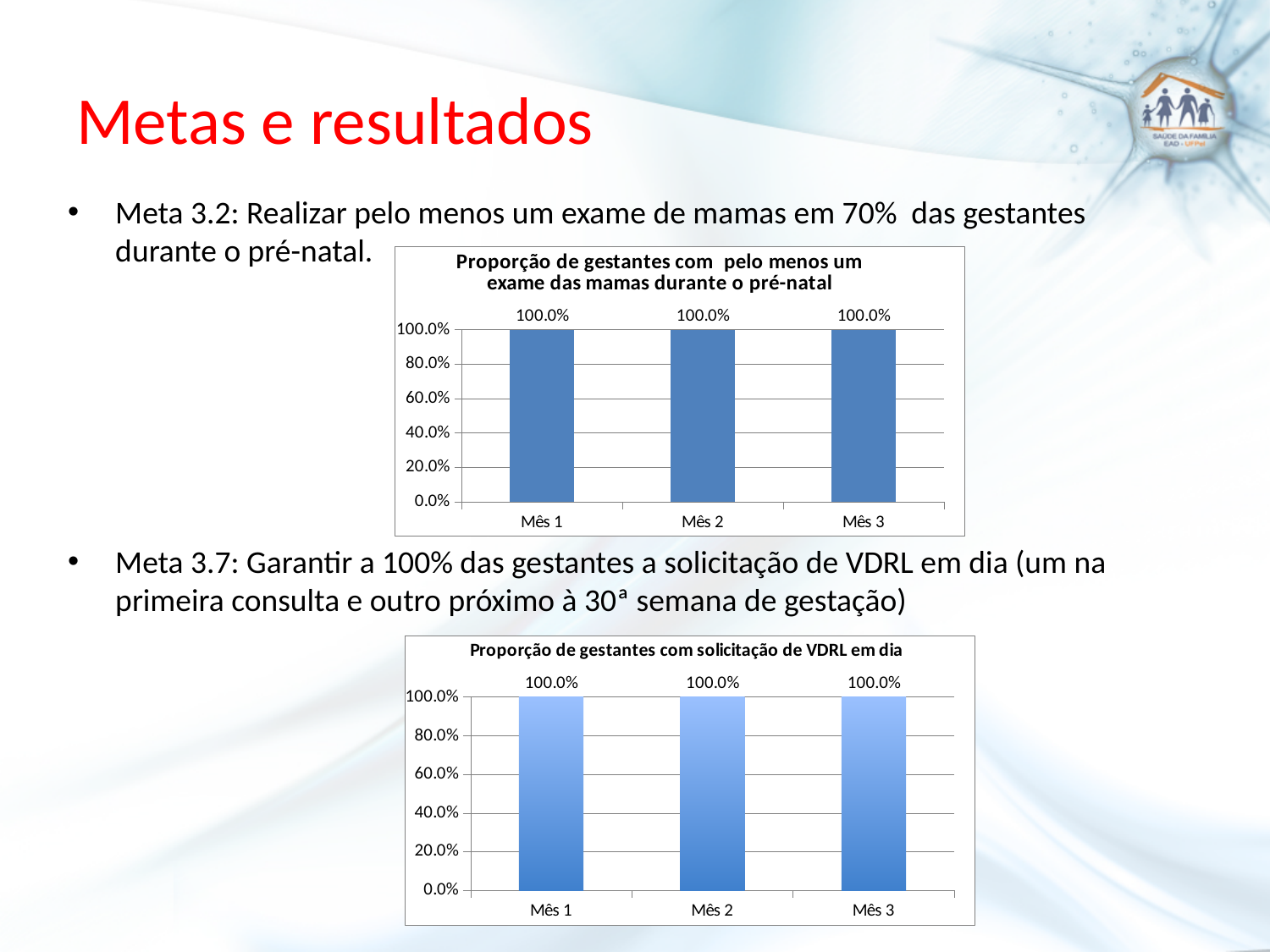
In the bottom chart (Proporção de gestantes com solicitação de VDRL em dia), what is the difference between the values for Mês 3 and Mês 1? 0.0% In the top chart (Proporção de gestantes com pelo menos um exame das mamas durante o pré-natal), what is the value for Mês 1? 100.0% In the top chart (Proporção de gestantes com pelo menos um exame das mamas durante o pré-natal), is the value for Mês 2 greater or less than 80.0%? greater In the top chart (Proporção de gestantes com pelo menos um exame das mamas durante o pré-natal), what is the difference between the values for Mês 1 and Mês 2? 0.0% In the bottom chart (Proporção de gestantes com solicitação de VDRL em dia), do the values rise, fall or stay the same from Mês 1 to Mês 3? Stay the same In the top chart (Proporção de gestantes com pelo menos um exame das mamas durante o pré-natal), what is the value for Mês 3? 100.0% What is the title of the bottom chart on the slide? Proporção de gestantes com solicitação de VDRL em dia What kind of chart is the top chart (Proporção de gestantes com pelo menos um exame das mamas durante o pré-natal)? Bar chart In the bottom chart (Proporção de gestantes com solicitação de VDRL em dia), what is the value for Mês 2? 100.0% In the bottom chart (Proporção de gestantes com solicitação de VDRL em dia), what is the value for Mês 3? 100.0% In the top chart (Proporção de gestantes com pelo menos um exame das mamas durante o pré-natal), how many categories are shown on the x axis? 3 In the bottom chart (Proporção de gestantes com solicitação de VDRL em dia), how many bars are plotted? 3